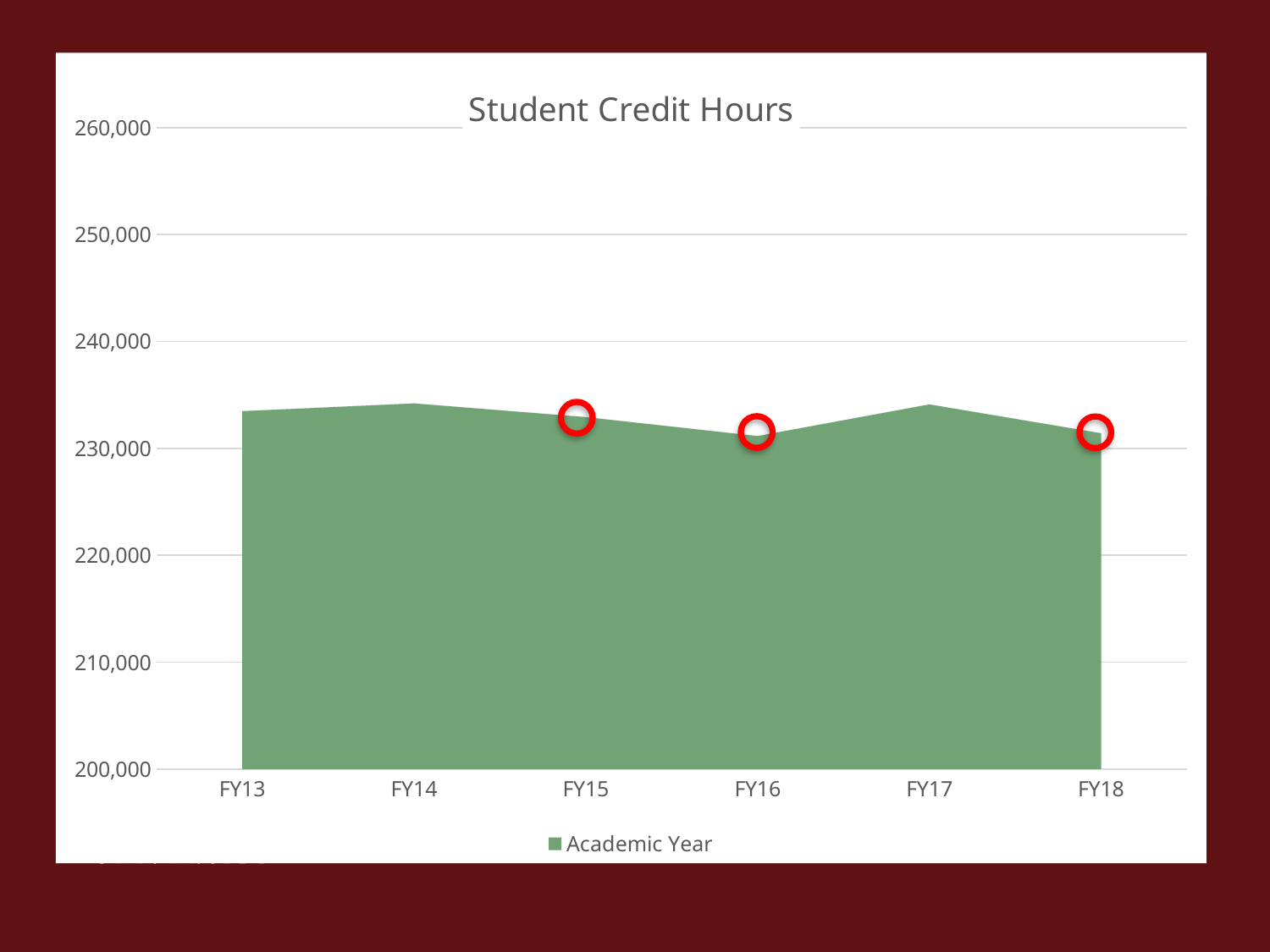
Do the values rise or fall from FY16 to FY17? rise Is the value for FY18 greater or less than 230,000? greater Is the value for FY14 greater or less than 240,000? less Do the values rise or fall from FY14 to FY16? fall How many series does the legend list? 1 How many fiscal years are shown on the x axis? 6 What is the name of the series shown in the legend? Academic Year Do the values rise or fall from FY17 to FY18? fall What is the title of the chart? Student Credit Hours Is the value for FY13 greater or less than 230,000? greater What kind of chart is shown on the slide? area chart